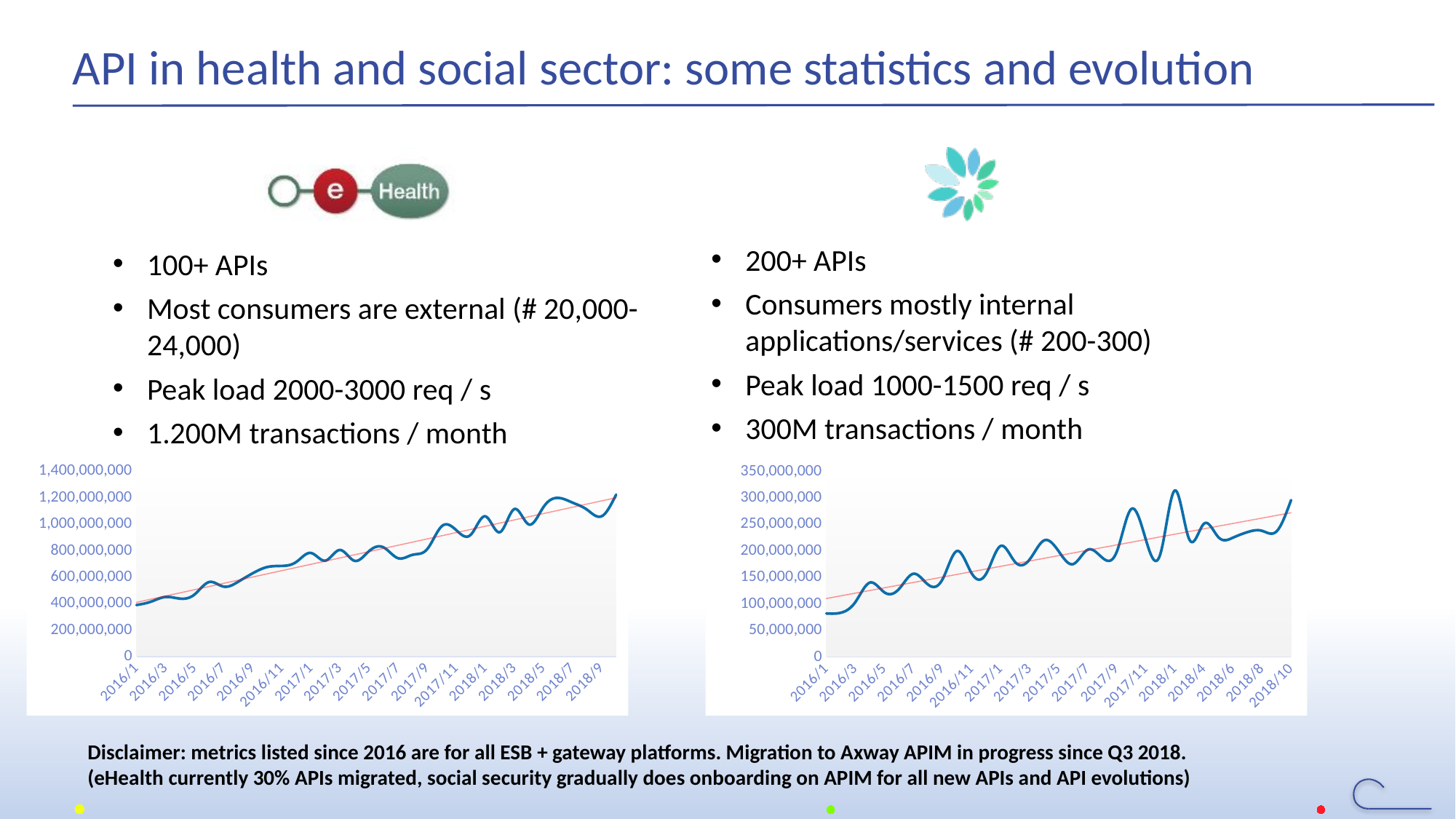
On the left chart, is the value for 2018/9 greater or less than 1,000,000,000? greater On the right chart, do the values generally rise or fall from 2016/1 to 2018/10? rise On the left chart, is the value for 2016/1 greater or less than 600,000,000? less On the left chart, do the values generally rise or fall from 2016/1 to 2018/9? rise On the left chart, which month has the lowest value? 2016/1 On the left chart, which is larger, the value for 2018/9 or the value for 2016/1? 2018/9 On the right chart, is the value for 2018/10 greater or less than 250,000,000? greater What is the highest value shown on the vertical axis of the right chart? 350,000,000 What kind of chart is the left chart below the eHealth bullets? line chart What is the highest value shown on the vertical axis of the left chart? 1,400,000,000 On the right chart, which month has the lowest value? 2016/1